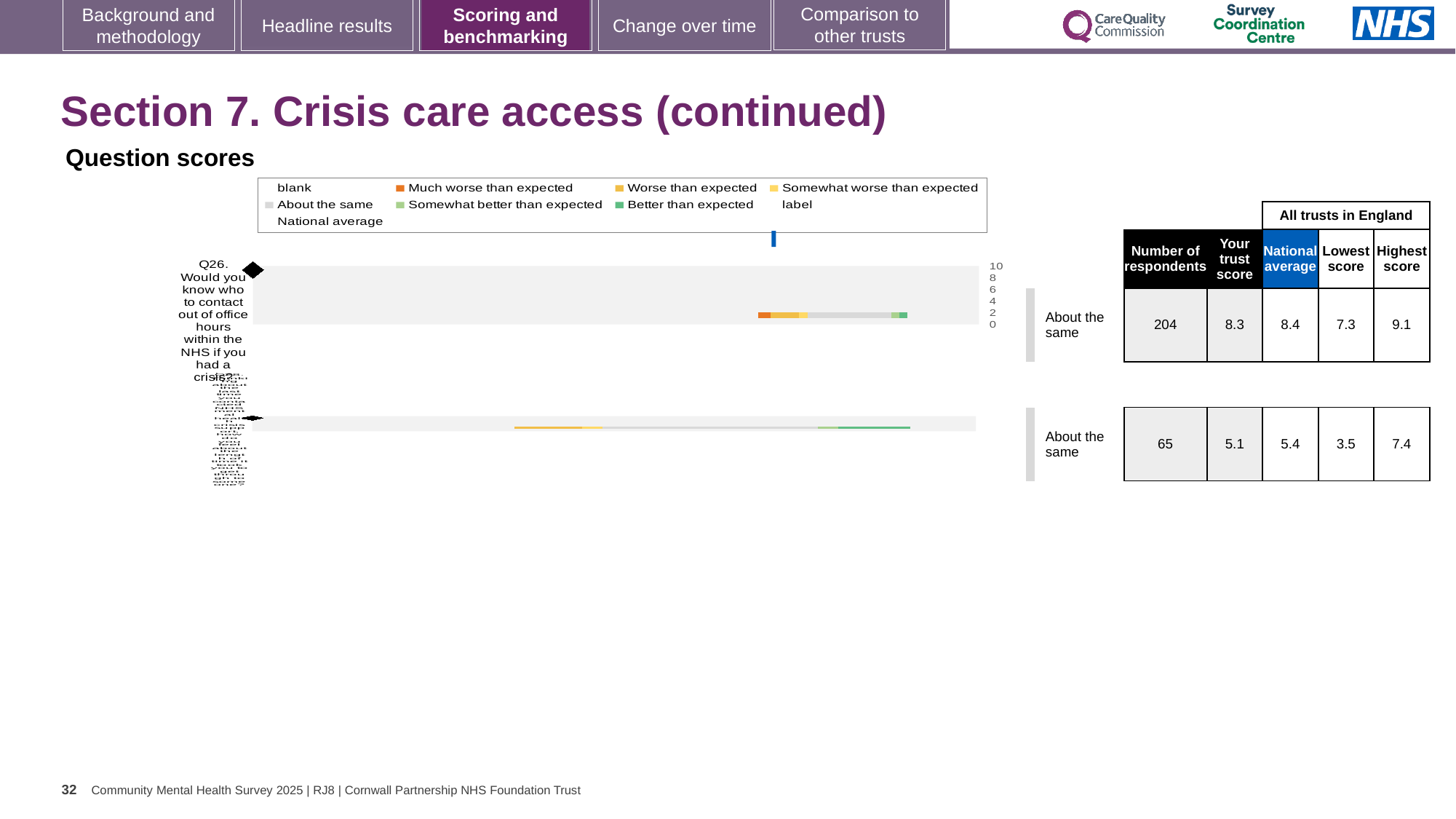
For Q26, what is the difference between the highest score and the lowest score among all trusts in England? 1.8 What is the highest score among all trusts in England for Q26? 9.1 What benchmark category is shown next to the Q26 bar? About the same What is the national average for Q26? 8.4 How many question rows are plotted in the question scores chart? 2 What is the number of respondents for Q26 (Would you know who to contact out of office hours within the NHS if you had a crisis?)? 204 In the legend, what colour represents 'Much worse than expected'? orange What kind of chart is used to show the question scores on this slide? bar chart What is the trust's score for Q26 in the question scores table? 8.3 For Q26, which is larger: the trust's score or the national average? national average What is the lowest score among all trusts in England for Q26? 7.3